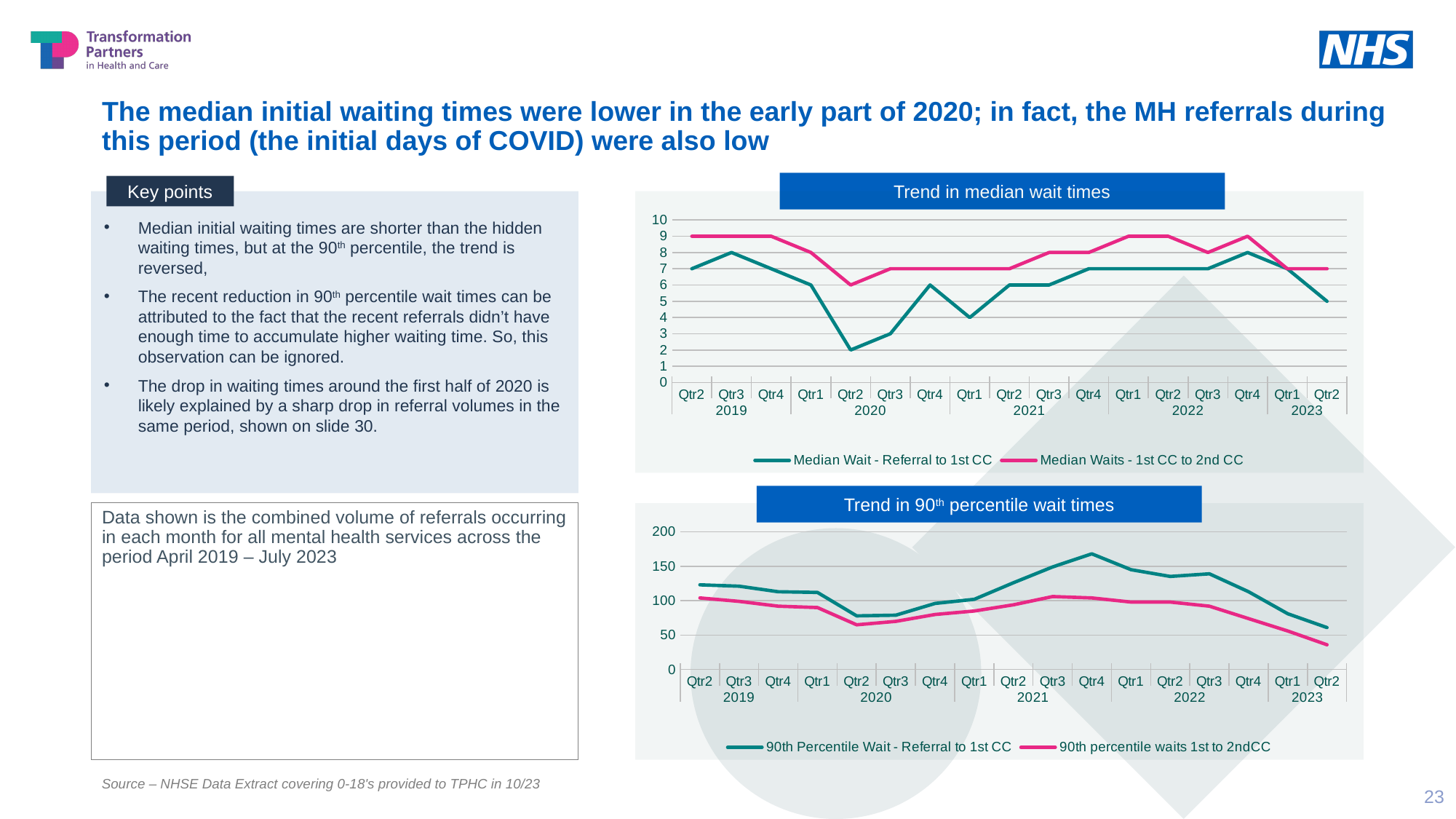
How many quarters are plotted on the x axis of the 'Trend in median wait times' chart? 17 In the 'Trend in median wait times' chart, what is the value of Median Wait - Referral to 1st CC in Qtr2 2020? 2 In the 'Trend in 90th percentile wait times' chart, is the value of 90th percentile waits 1st to 2ndCC in Qtr2 2023 greater or less than 50? less In the 'Trend in median wait times' chart, which series has the higher value in Qtr4 2022? Median Waits - 1st CC to 2nd CC In the 'Trend in median wait times' chart, what is the difference between Median Waits - 1st CC to 2nd CC and Median Wait - Referral to 1st CC in Qtr2 2020? 4 What kind of chart is the 'Trend in median wait times' chart? line chart In the 'Trend in 90th percentile wait times' chart, which series has the higher value in Qtr4 2021? 90th Percentile Wait - Referral to 1st CC In the 'Trend in median wait times' chart, in which quarter is Median Wait - Referral to 1st CC lowest? Qtr2 2020 In the 'Trend in 90th percentile wait times' chart, is the value of 90th Percentile Wait - Referral to 1st CC in Qtr4 2021 greater or less than 150? greater How many series does the legend of the 'Trend in median wait times' chart list? 2 In the 'Trend in median wait times' chart, what is the value of Median Waits - 1st CC to 2nd CC in Qtr2 2019? 9 In the 'Trend in 90th percentile wait times' chart, do the values of 90th Percentile Wait - Referral to 1st CC rise or fall from Qtr4 2021 to Qtr2 2023? fall